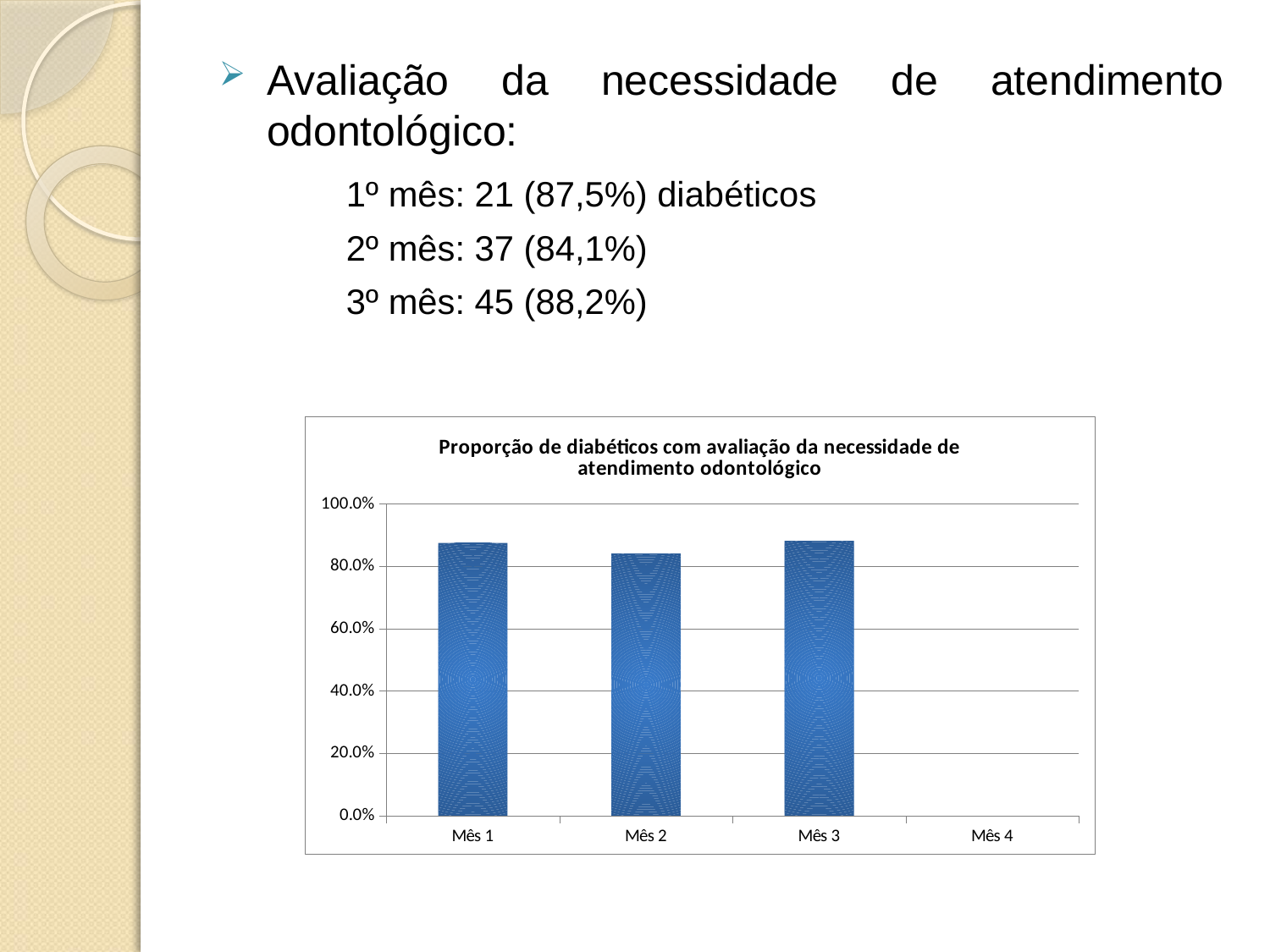
What colour are the bars in the chart? blue Is the value for Mês 1 greater or less than 80.0%? greater How many categories are labelled on the x axis of the chart? 4 Which category has the lowest bar in the chart? Mês 2 Which is larger, the value for Mês 1 or the value for Mês 2? Mês 1 What kind of chart is shown on the slide? bar chart Which is larger, the value for Mês 2 or the value for Mês 3? Mês 3 Is the value for Mês 2 greater or less than 80.0%? greater Is the value for Mês 2 greater or less than 60.0%? greater How many bars are plotted in the chart? 3 What is the title of the chart? Proporção de diabéticos com avaliação da necessidade de atendimento odontológico